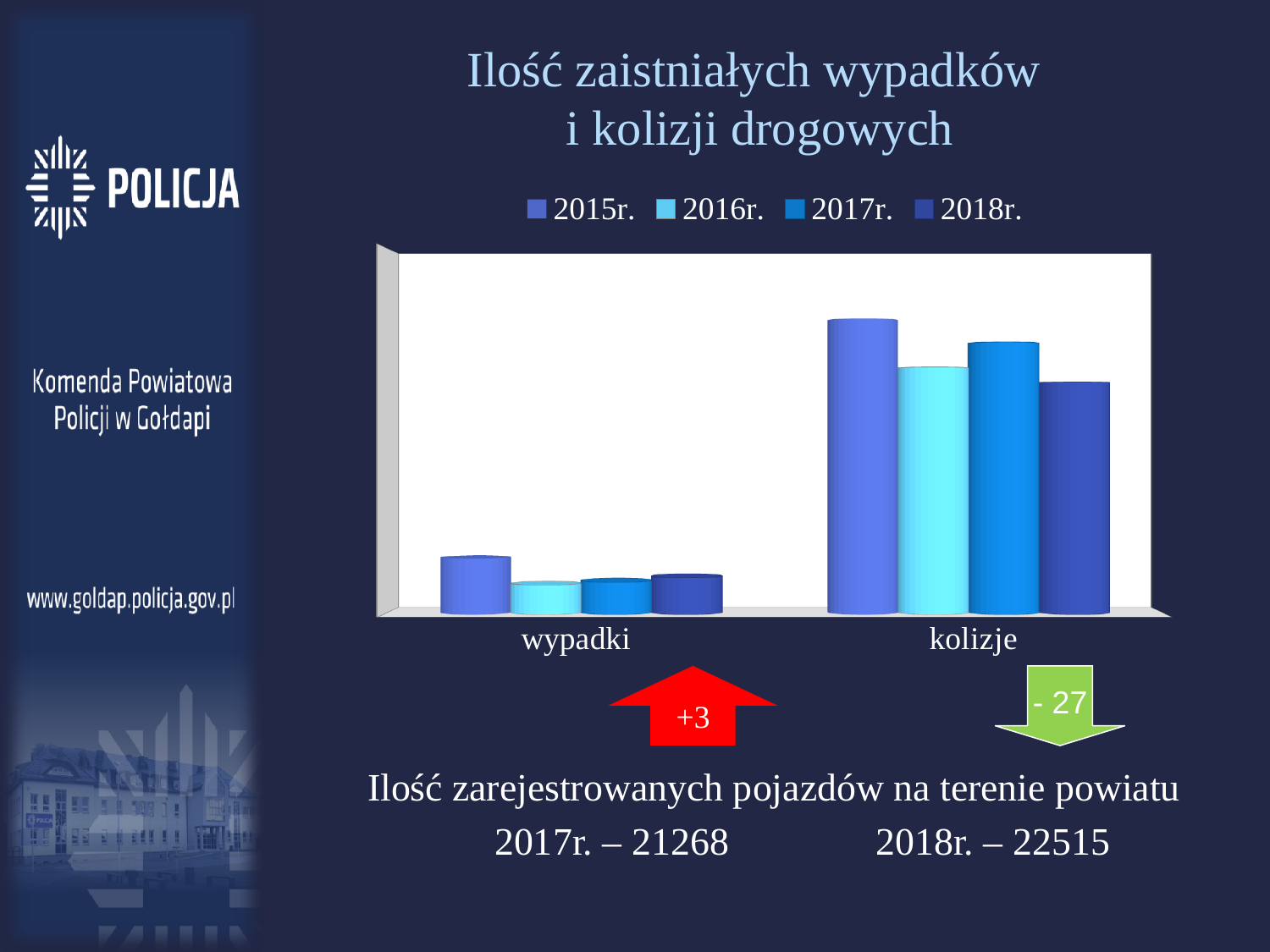
For 2018r., which category has the larger bar: wypadki or kolizje? kolizje What is the title of the chart? Ilość zaistniałych wypadków i kolizji drogowych For 2015r., which category has the smaller bar: wypadki or kolizje? wypadki Which years are listed in the chart legend? 2015r., 2016r., 2017r., 2018r. Which year has the highest bar for wypadki? 2015r. What kind of chart is shown on the slide? bar chart How many series does the legend list? 4 How many categories are shown on the x axis? 2 For kolizje, which is larger: the 2016r. bar or the 2017r. bar? 2017r. Which year has the highest bar for kolizje? 2015r. Which year has the lowest bar for kolizje? 2018r.